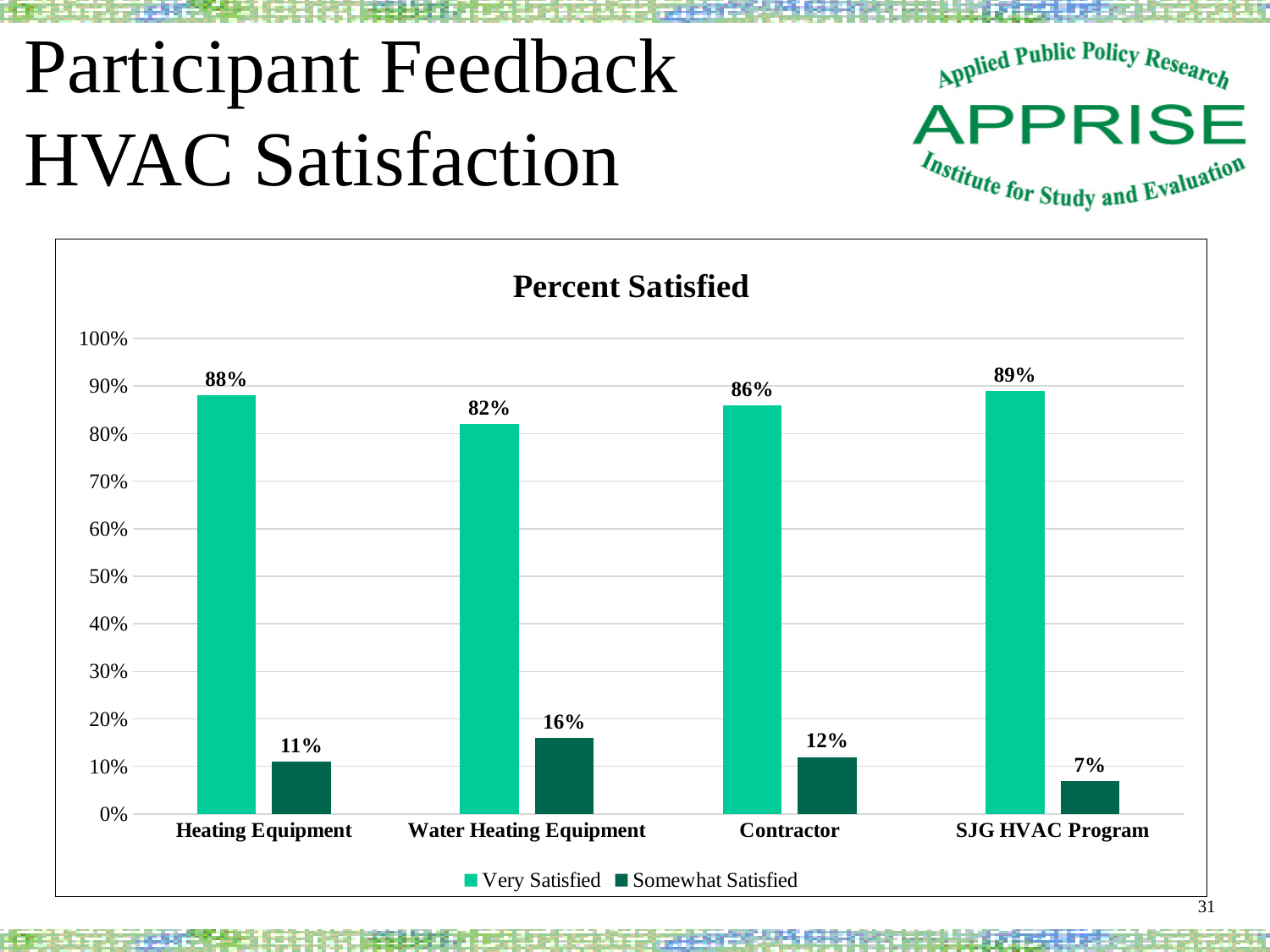
Which category has the lowest Somewhat Satisfied value? SJG HVAC Program Which category has the highest Very Satisfied value? SJG HVAC Program What is the difference between the Very Satisfied values for Heating Equipment and Water Heating Equipment? 6% How many series does the legend list? 2 What is the Very Satisfied value for Heating Equipment? 88% Which category has the lowest Very Satisfied value? Water Heating Equipment Which is larger, the Somewhat Satisfied value for Contractor or for Water Heating Equipment? Water Heating Equipment What is the Somewhat Satisfied value for SJG HVAC Program? 7% What is the title of the chart? Percent Satisfied What is the Somewhat Satisfied value for Water Heating Equipment? 16% What kind of chart is shown? Bar chart How many categories are shown on the x axis? 4